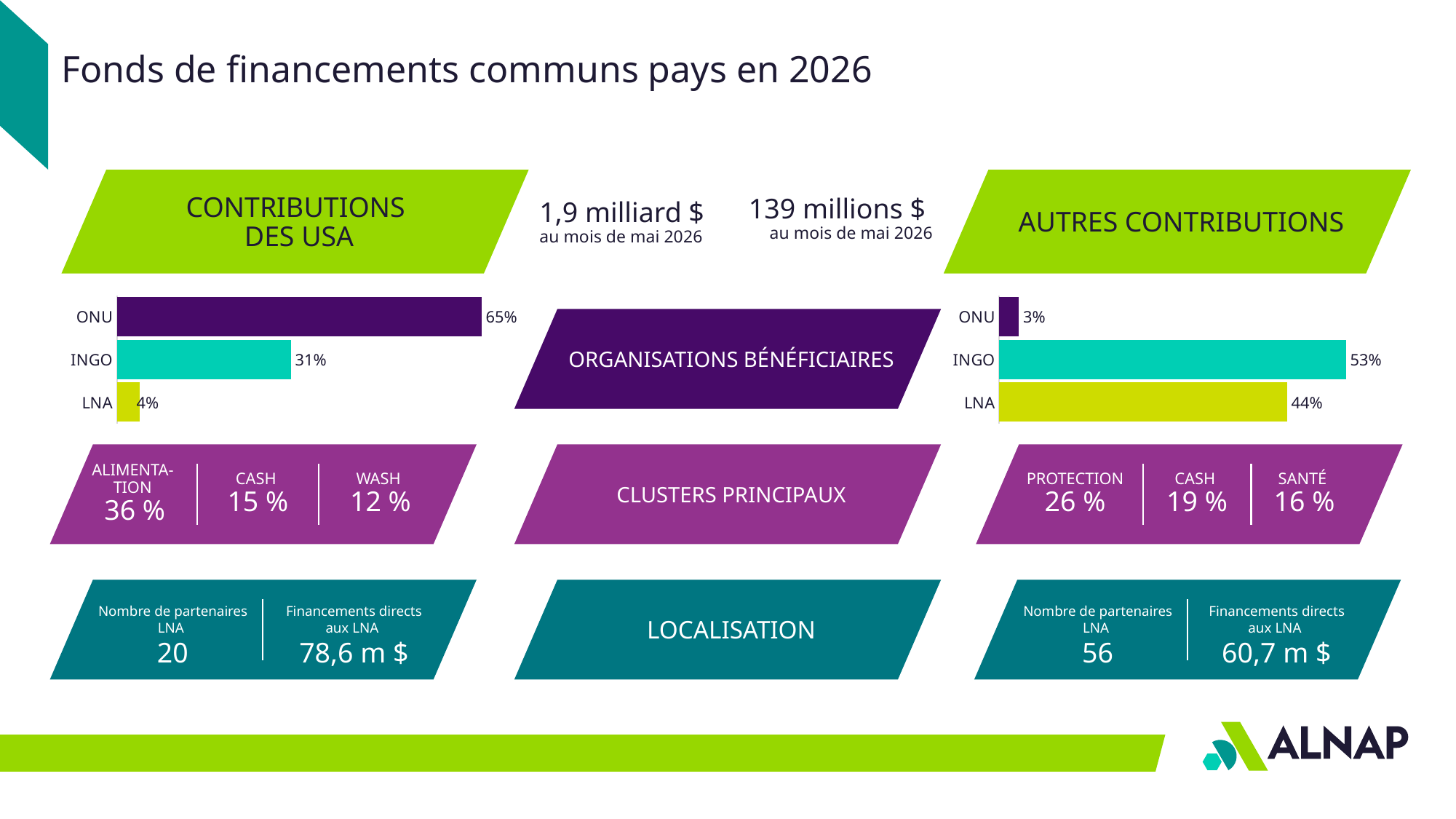
In the Autres contributions chart, which category has the lowest value? ONU In the Contributions des USA chart, which category has the highest value? ONU In the Autres contributions chart, what is the value for LNA? 44% In the Autres contributions chart, which category has the highest value? INGO In the Autres contributions chart, what is the value for ONU? 3% In the Contributions des USA chart, what is the difference between the ONU and INGO values? 34% In the Autres contributions chart, what is the difference between the INGO and LNA values? 9% How many categories does the Autres contributions chart show? 3 In the Contributions des USA chart, what is the value for INGO? 31% In the Contributions des USA chart, what is the value for ONU? 65% What kind of chart is the Contributions des USA chart? Bar chart In the Contributions des USA chart, which is larger, the value for INGO or the value for LNA? INGO